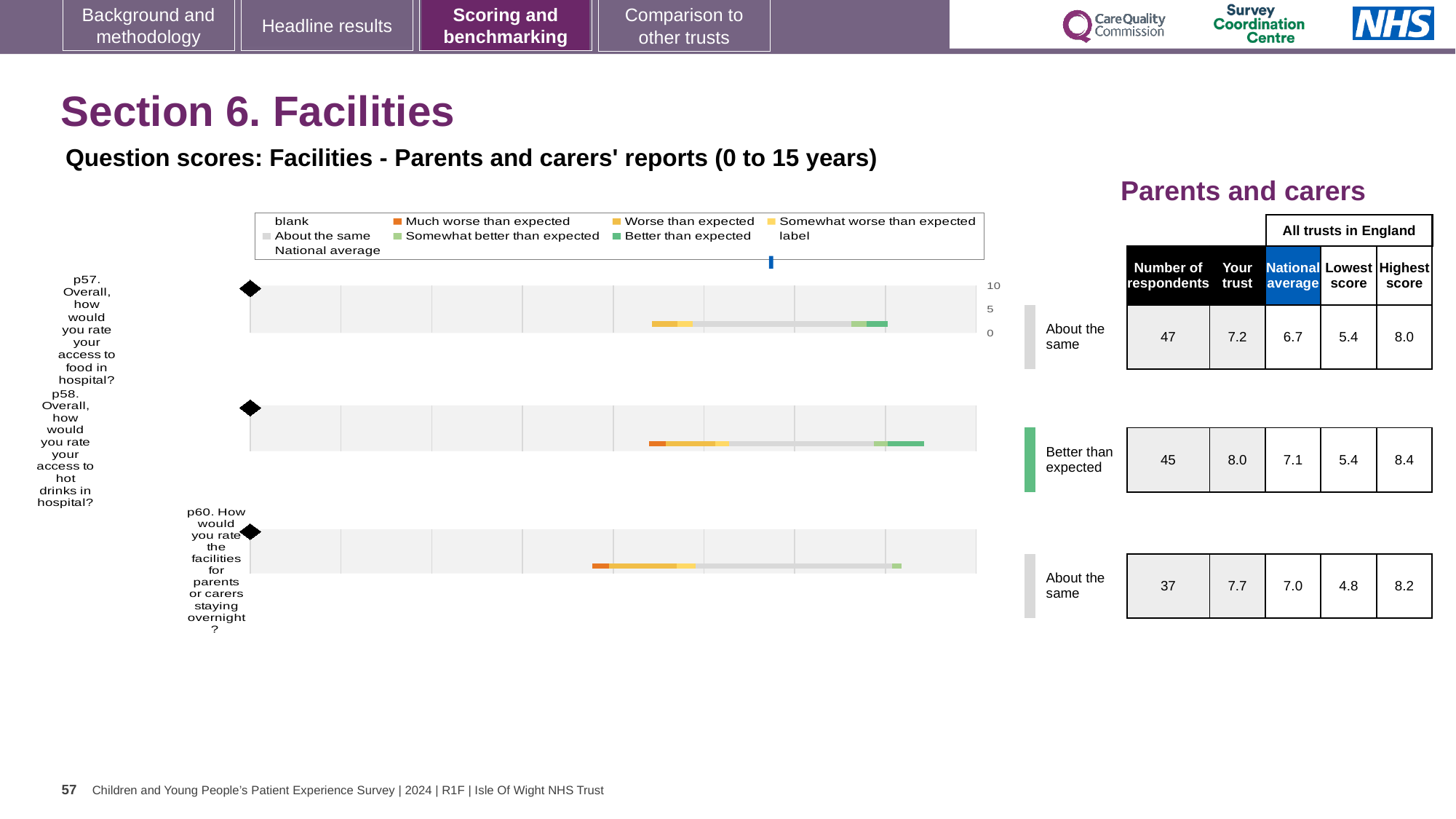
What is the 'Your trust' score for p57 (access to food in hospital)? 7.2 What is the difference between the 'Your trust' score and the national average for p58? 0.9 Is the 'Your trust' score for p57 higher or lower than the national average for p57? higher What kind of chart is used to show the question scores on this slide? bar chart Which question has the highest 'Your trust' score? p58 How many questions (categories) are plotted in the chart? 3 What is the highest score among all trusts in England for p58? 8.4 What is the national average score for p58 (access to hot drinks in hospital)? 7.1 What is the lowest score among all trusts in England for p60? 4.8 How many respondents answered p60 (facilities for parents or carers staying overnight)? 37 Which benchmark category is p58 rated as? Better than expected Which question has the lowest 'Your trust' score? p57